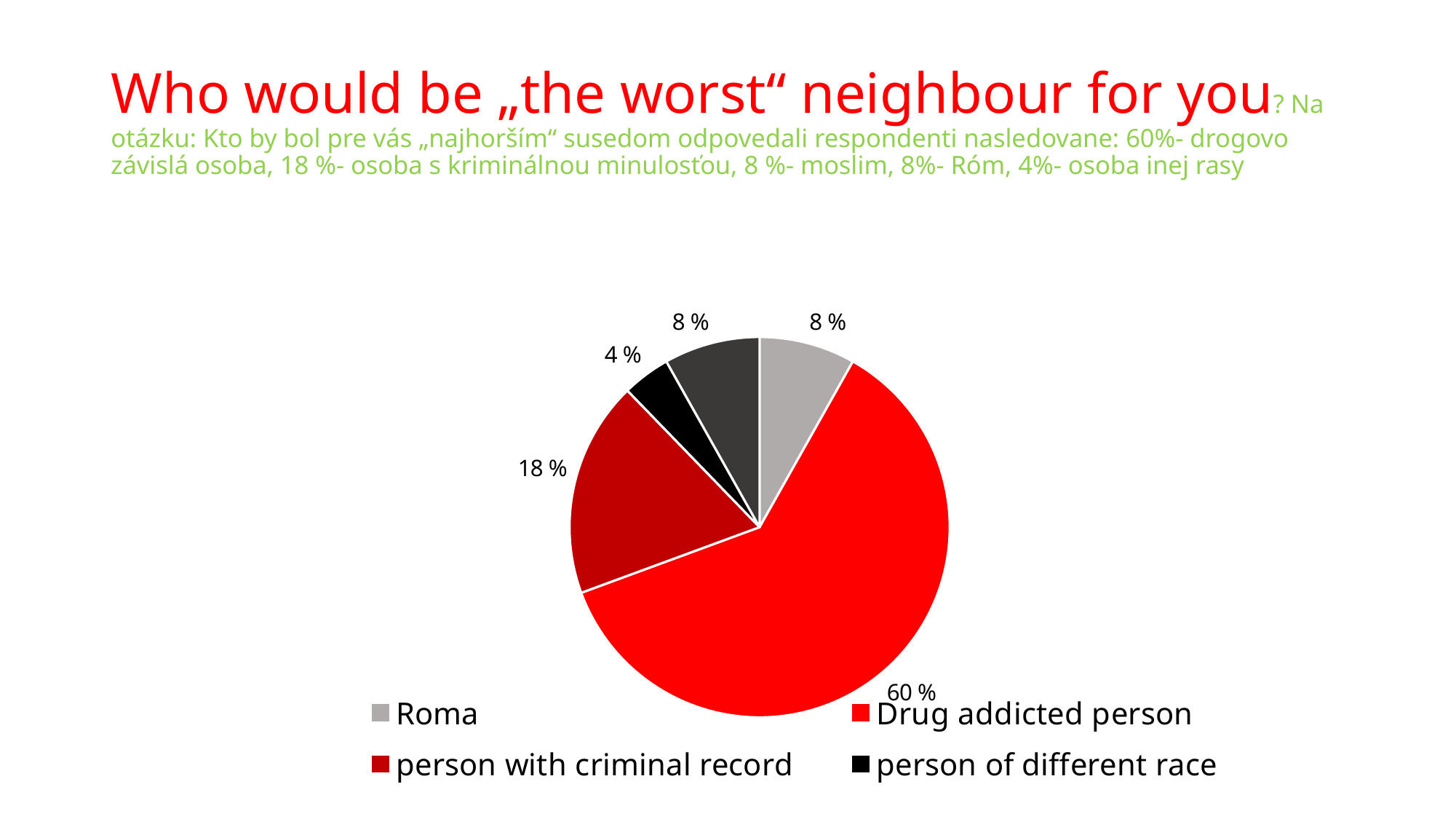
What percentage is shown for "person of different race"? 4 % Which category has the smallest share of the pie? person of different race What colour is the slice for "Drug addicted person"? red How many slices does the pie chart have? 5 Which category has the largest share of the pie? Drug addicted person What kind of chart is shown on the slide? pie chart What percentage is shown for "person with criminal record"? 18 % What percentage is shown for "Roma"? 8 % How many entries does the legend list? 4 Which is larger: the share for "Roma" or the share for "person of different race"? Roma What percentage of respondents chose "Drug addicted person" as the worst neighbour? 60 % What is the difference in percentage points between "Drug addicted person" and "person with criminal record"? 42